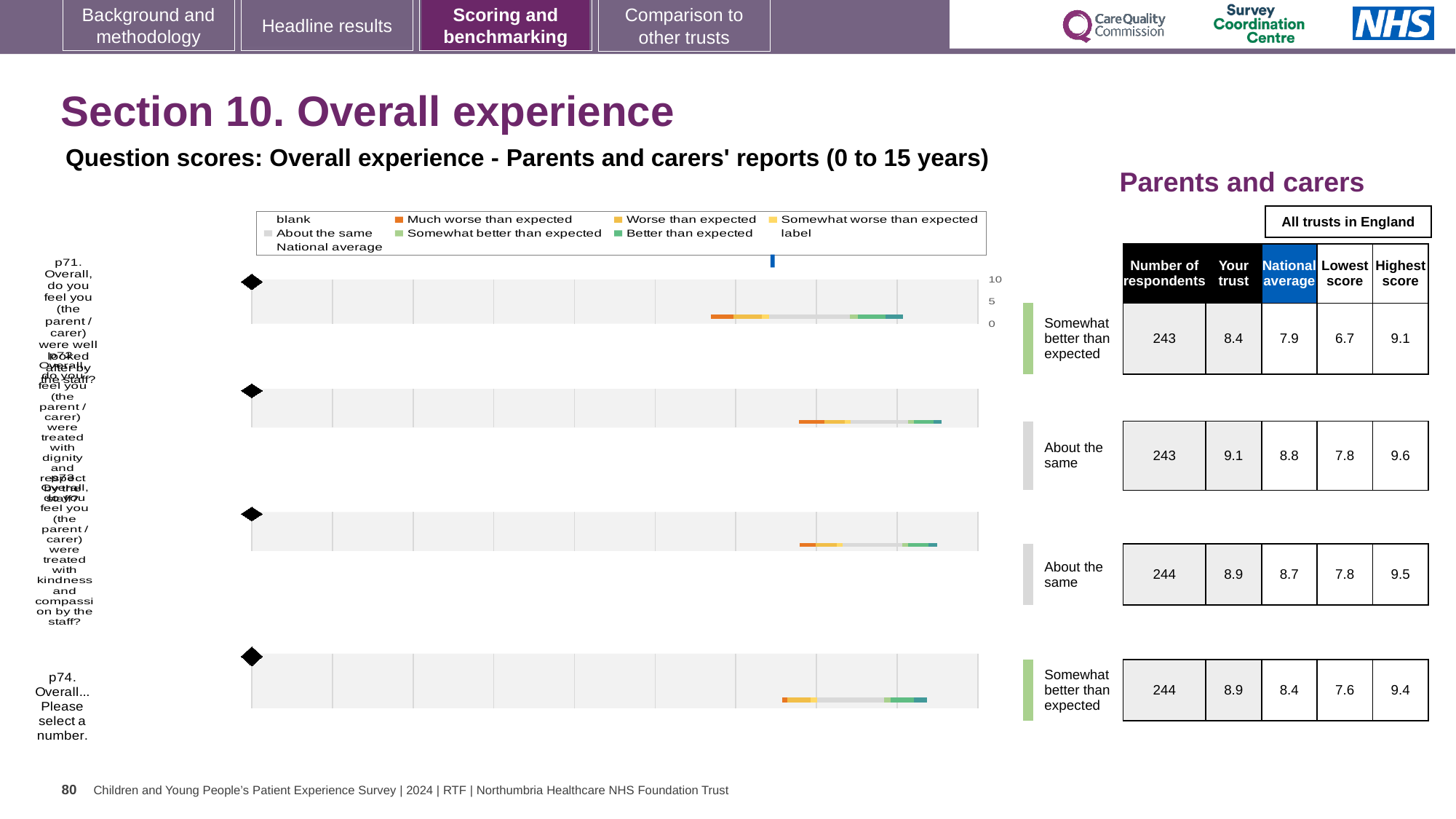
What is the national average score for p72 (treated with dignity and respect)? 8.8 For p72, which is larger: the 'Your trust' score or the national average? Your trust What is the difference between the 'Your trust' score and the national average for p71? 0.5 What is the highest score across all trusts in England for p73 (treated with kindness and compassion)? 9.5 What kind of chart is shown on the slide? bar chart What is the 'Your trust' score for p71 (were you, the parent/carer, well looked after by the staff)? 8.4 How many respondents answered p74 (Overall... Please select a number)? 244 What benchmark category is shown for p74? Somewhat better than expected How many questions (rows) are plotted in the chart? 4 Which question has the lowest 'Your trust' score? p71 Which question has the highest 'Your trust' score? p72 What is the lowest score across all trusts in England for p74? 7.6